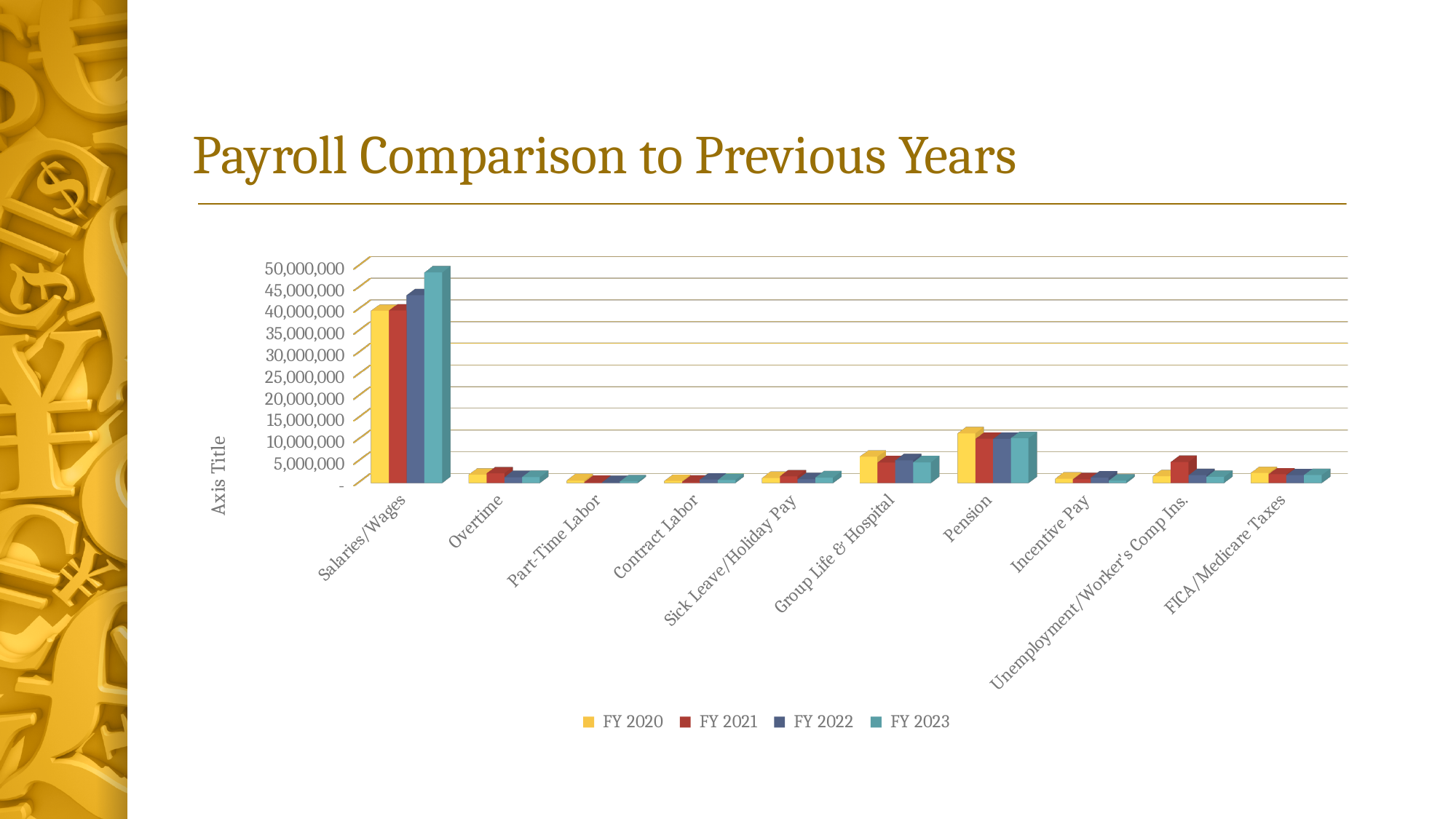
Is the FY 2023 value for Overtime greater or less than 5,000,000? less For Unemployment/Worker's Comp Ins., which is larger: the FY 2020 value or the FY 2021 value? FY 2021 What is the title of the slide containing the chart? Payroll Comparison to Previous Years What kind of chart is shown on the slide? bar chart For FY 2020, which category has the larger value: Pension or Group Life & Hospital? Pension Is the FY 2020 value for Pension greater or less than 5,000,000? greater Which category has the highest values in the chart? Salaries/Wages Is the FY 2023 value for Salaries/Wages greater or less than 45,000,000? greater How many series does the chart's legend list? 4 How many categories are shown on the x axis of the chart? 10 For Salaries/Wages, which is larger: the FY 2020 value or the FY 2023 value? FY 2023